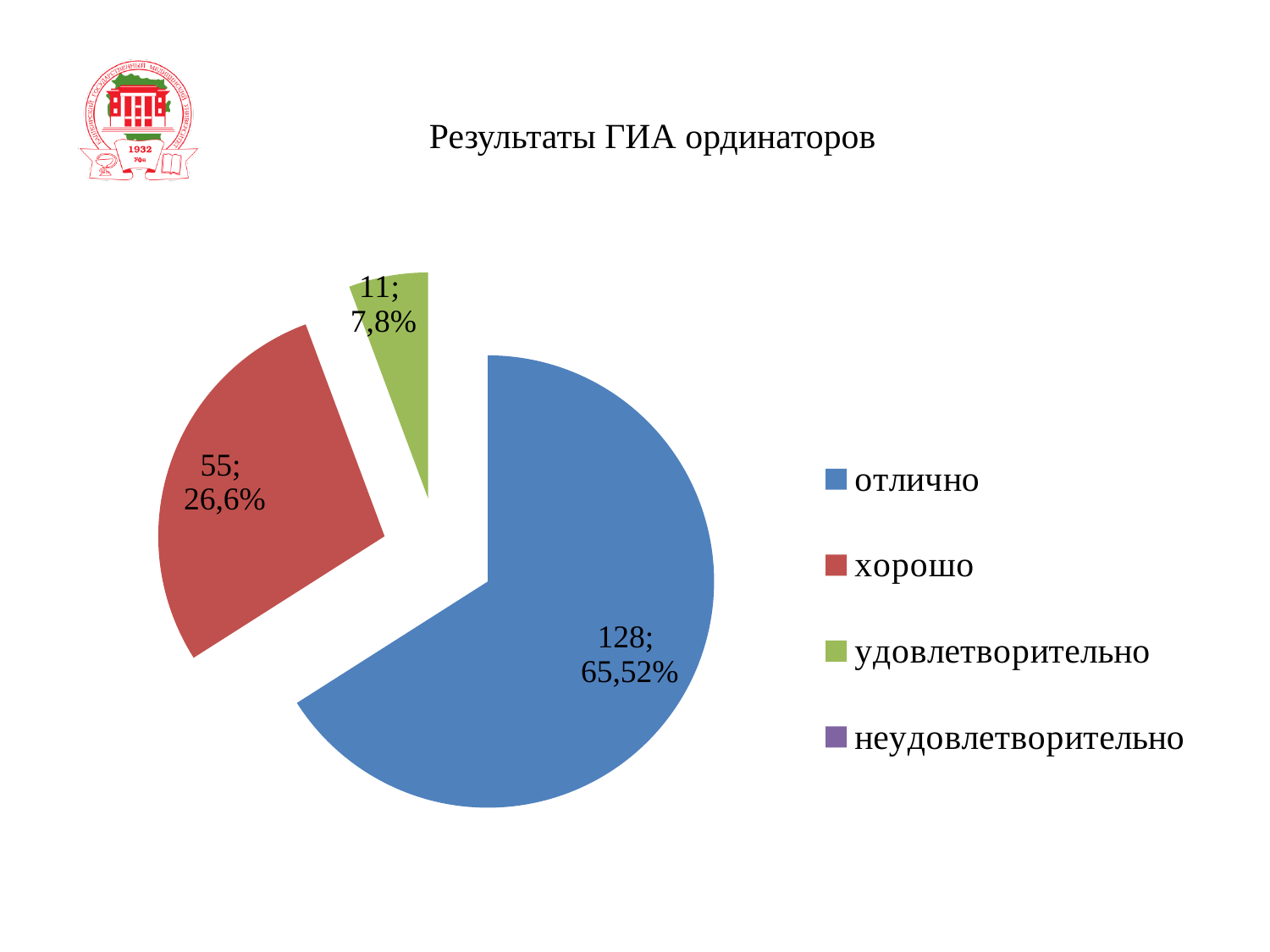
What is the count shown for the 'хорошо' slice? 55 What is the difference between the counts for 'отлично' and 'хорошо'? 73 What is the count shown for the 'удовлетворительно' slice? 11 What share of the pie does the 'отлично' slice represent? 65,52% What is the title of the chart? Результаты ГИА ординаторов What is the count shown for the 'отлично' slice? 128 What type of chart is shown on the slide? pie chart How many slices are visible in the pie chart? 3 Which visible slice is the smallest? удовлетворительно How many entries does the chart legend list? 4 Which category has the largest slice? отлично What share of the pie does the 'хорошо' slice represent? 26,6%